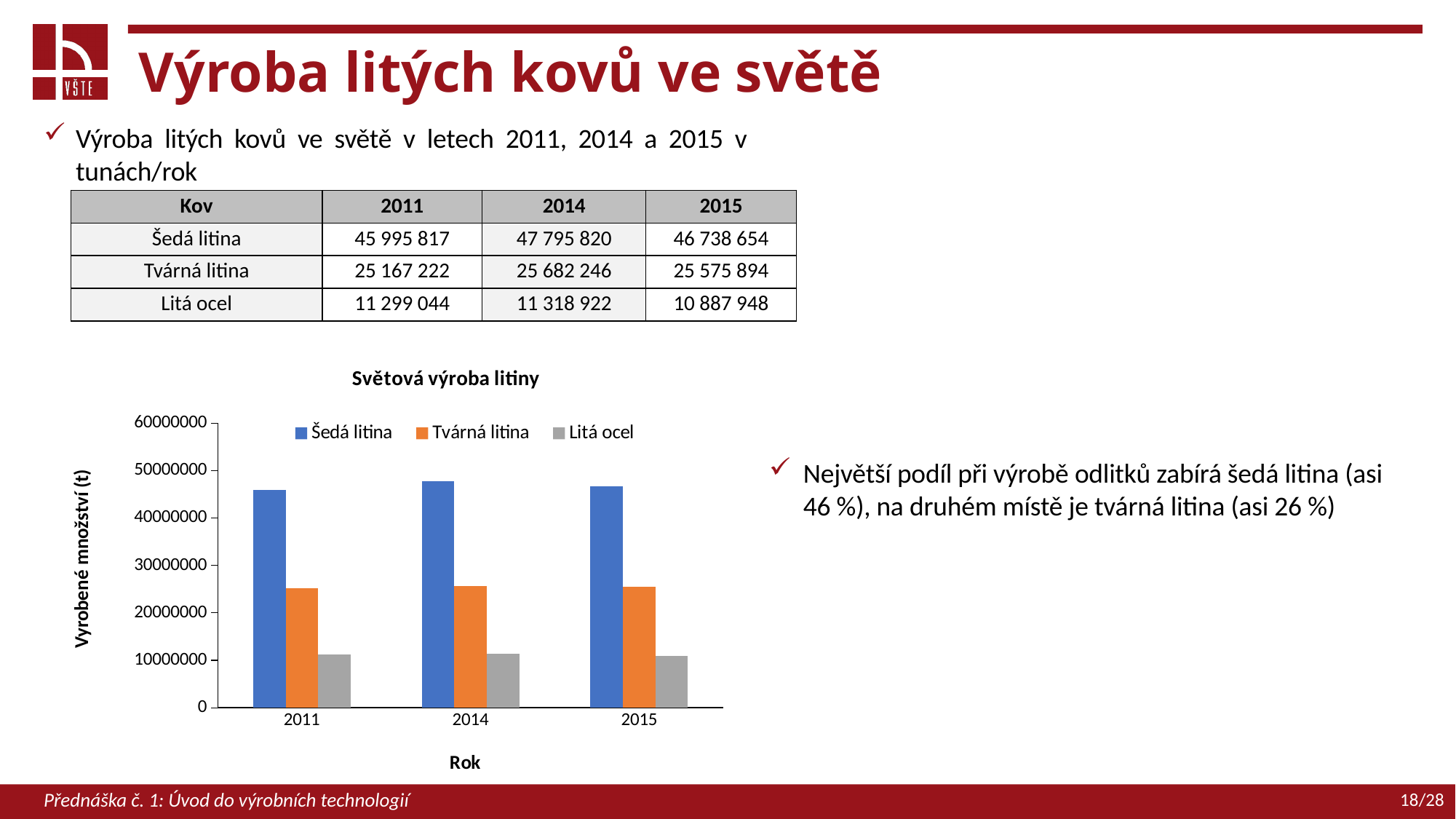
How many series does the legend of the 'Světová výroba litiny' chart list? 3 Which series has the highest bar in every year of the 'Světová výroba litiny' chart? Šedá litina According to the table on the slide, what was the production of Šedá litina in 2014? 47 795 820 Using the table values, by how much did Šedá litina production in 2014 exceed that in 2011? 1 800 003 In the 'Světová výroba litiny' chart, is the bar for Tvárná litina in 2015 taller or shorter than the bar for Litá ocel in 2015? taller What is the label of the y axis of the 'Světová výroba litiny' chart? Vyrobené množství (t) In the 'Světová výroba litiny' chart, is the value for Šedá litina in 2011 greater or less than 40000000? greater Which series has the lowest bar in every year of the 'Světová výroba litiny' chart? Litá ocel What type of chart is shown under the title 'Světová výroba litiny'? bar chart In the 'Světová výroba litiny' chart, is the value for Tvárná litina in 2014 greater or less than 30000000? less According to the table on the slide, what was the production of Litá ocel in 2015? 10 887 948 How many years are shown on the x axis of the 'Světová výroba litiny' chart? 3